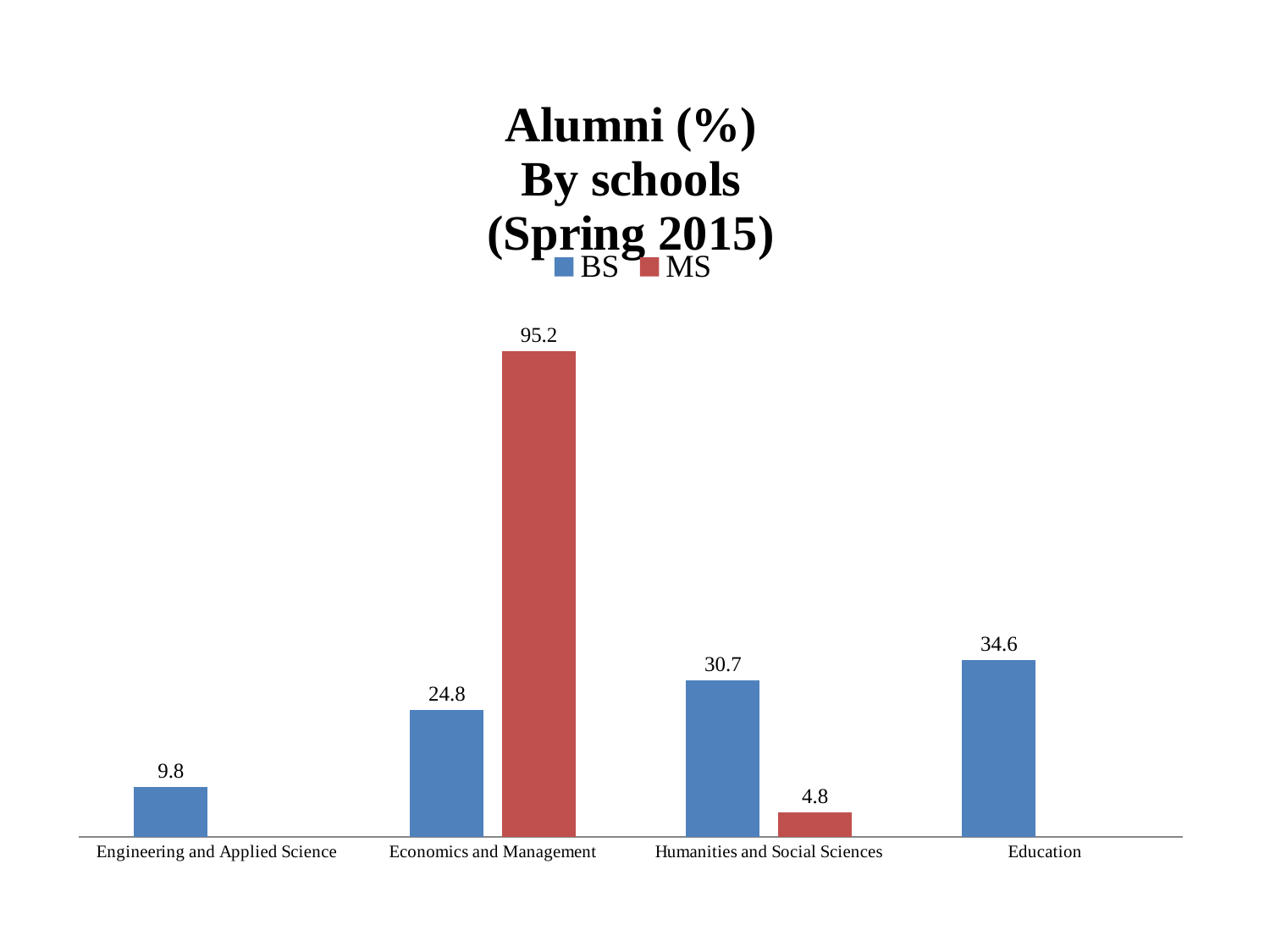
What is the BS value for Humanities and Social Sciences? 30.7 What is the BS value for Engineering and Applied Science? 9.8 How many series does the legend list? 2 What kind of chart is shown on the slide? Bar chart Which is larger: the BS value for Education or the BS value for Humanities and Social Sciences? Education What is the BS value for Education? 34.6 What is the MS value for Economics and Management? 95.2 Which school has the highest BS value? Education What is the MS value for Humanities and Social Sciences? 4.8 What is the difference between the MS and BS values for Economics and Management? 70.4 Which school has the lowest BS value? Engineering and Applied Science How many schools are shown on the x axis? 4